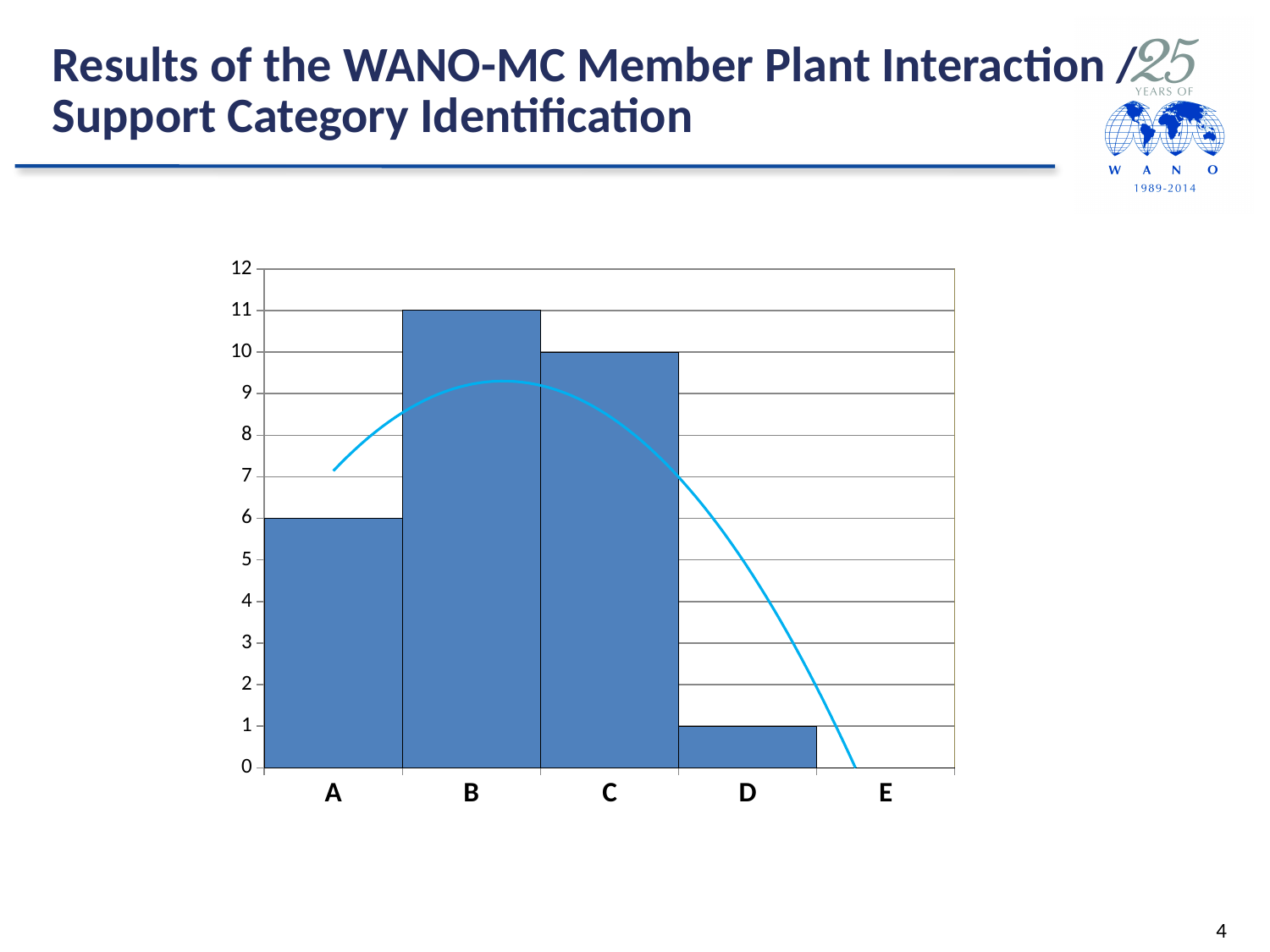
What is the value for category A? 6 What is the difference between the values for B and A? 5 Which category has the highest bar? B Which is larger, the value for A or the value for C? C How many categories are shown on the x axis? 5 Do the bar values rise or fall from category C to category D? Fall What is the value for category B? 11 Which category with a visible bar has the lowest value? D What is the value for category C? 10 What is the difference between the values for C and D? 9 What kind of chart is shown on the slide? Bar chart What is the value for category D? 1